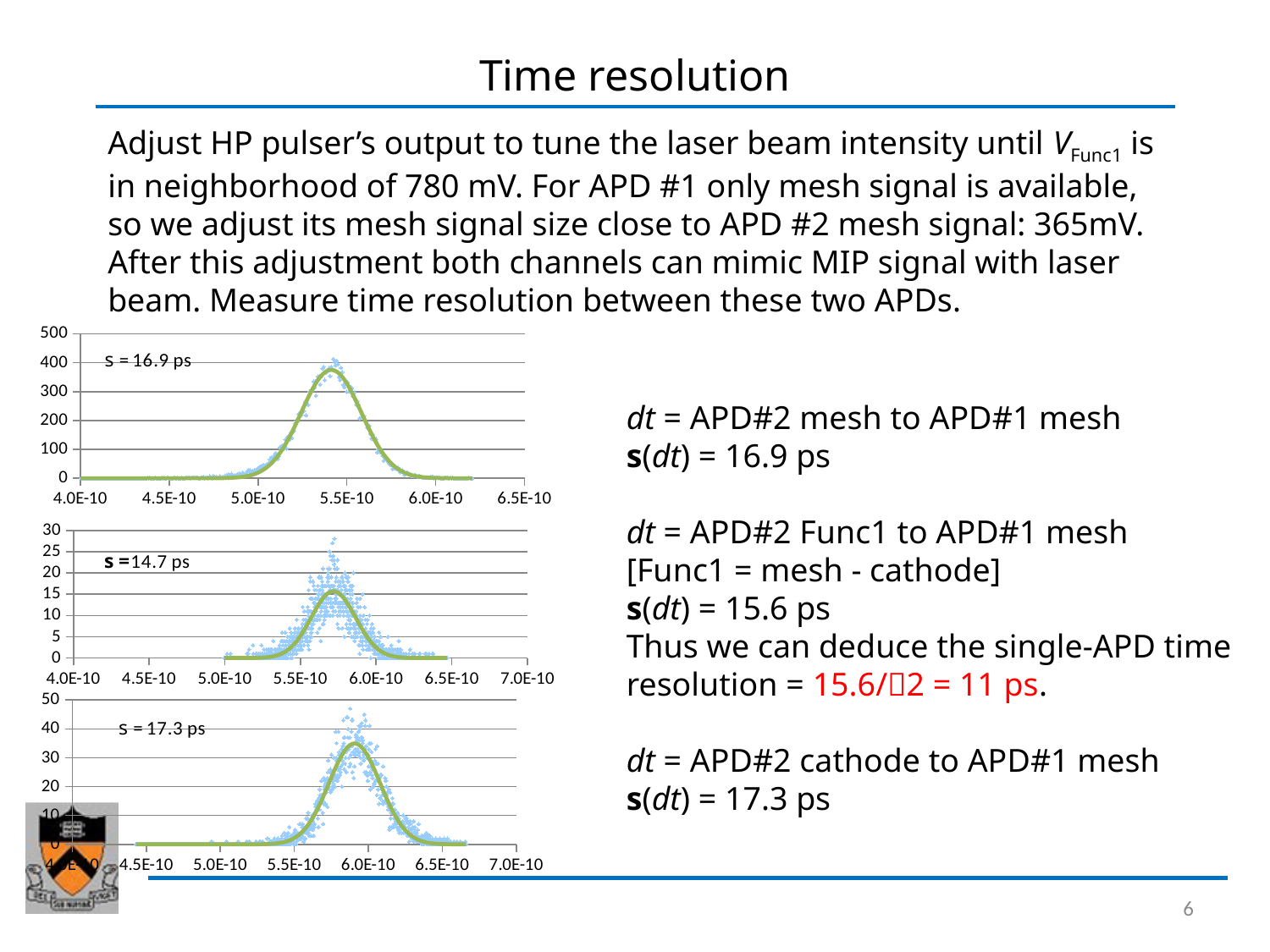
In the top chart, is the peak of the fitted curve greater or less than 300? greater Which chart has the lowest peak value on its y axis: the top, middle, or bottom chart? middle What kind of chart is the top chart on the slide? scatter chart In the top chart, is the x position of the peak greater or less than 5.0E-10? greater In the middle chart, is the peak of the fitted curve greater or less than 20? less In the middle chart, what value of s is annotated on the plot? s = 14.7 ps In the top chart, what value of s is annotated on the plot? s = 16.9 ps How many charts are shown on the slide? 3 Which chart has the highest peak value on its y axis: the top, middle, or bottom chart? top